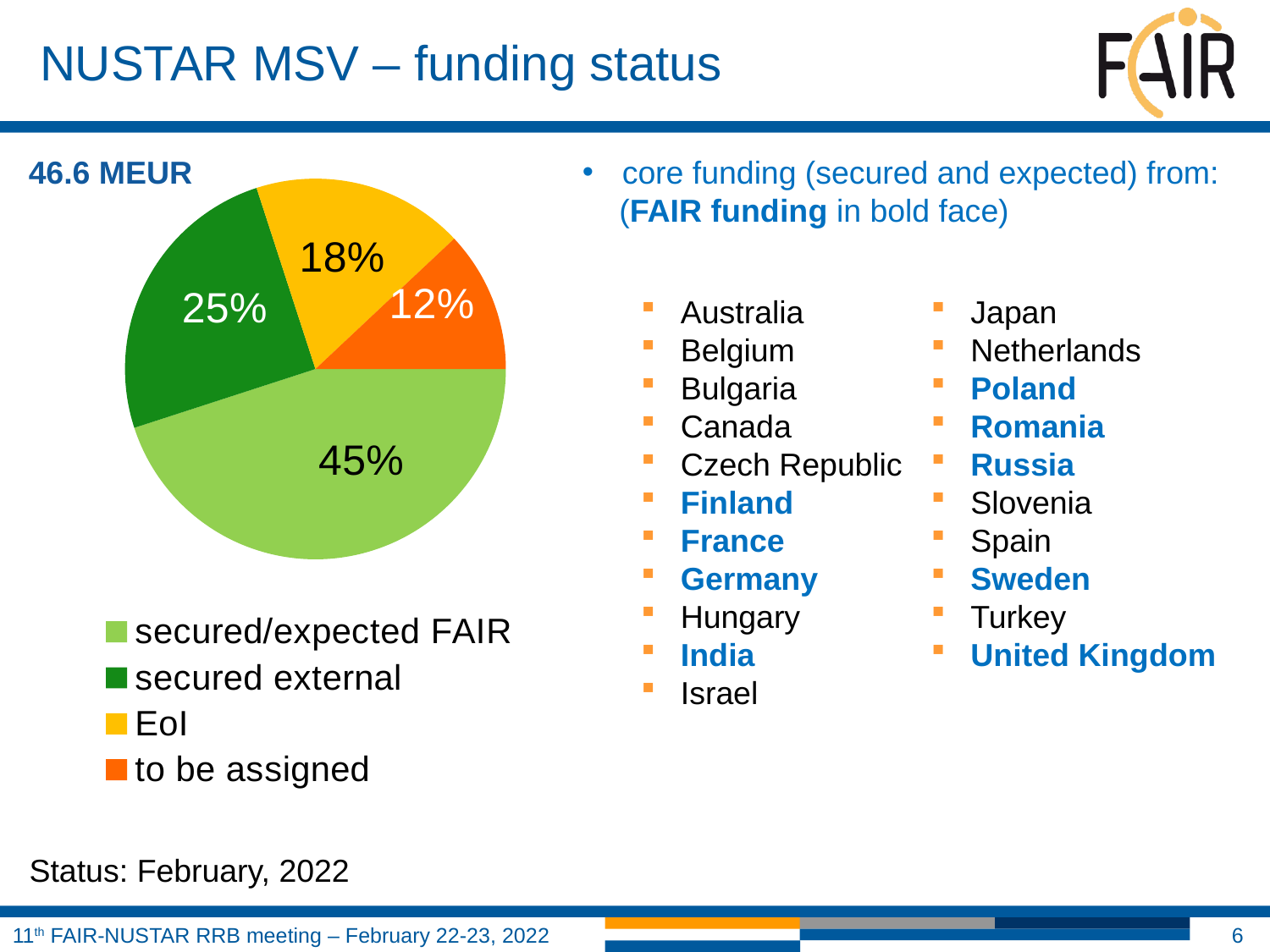
Which category has the smallest slice of the pie? to be assigned Which is larger, the share for "EoI" or the share for "to be assigned"? EoI What share of the pie does "to be assigned" represent? 12% How many slices does the pie chart have? 4 What total amount is shown above the pie chart? 46.6 MEUR What kind of chart is shown on the slide? pie chart What share of the pie does "secured/expected FAIR" represent? 45% What share of the pie does "secured external" represent? 25% What colour is the "to be assigned" slice in the pie chart? orange What is the difference in percentage points between "secured/expected FAIR" and "secured external"? 20 Which category has the largest slice of the pie? secured/expected FAIR